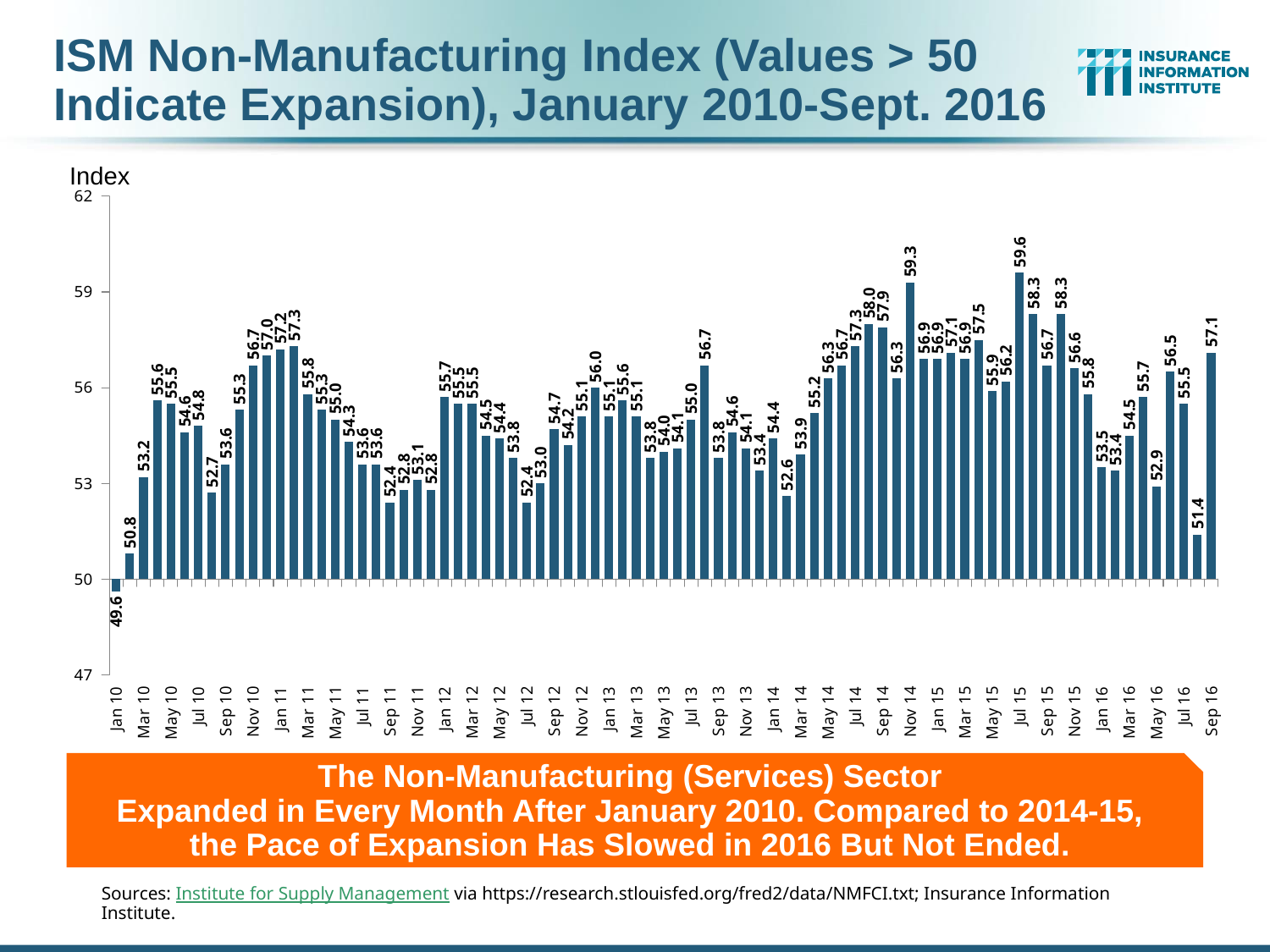
Which is larger, the value for Jul 15 or the value for Nov 14? Jul 15 What is the ISM Non-Manufacturing Index value for Sep 16, the last bar on the chart? 57.1 What is the difference between the Sep 16 value (57.1) and the Jan 10 value (49.6)? 7.5 What is the highest value shown on the chart? 59.6 Is the value for Jan 10 greater or less than 50? less What type of chart is shown on the slide? bar chart Which month has the highest ISM Non-Manufacturing Index value on the chart? Jul 15 What is the ISM Non-Manufacturing Index value for Nov 14? 59.3 Which month has the lowest ISM Non-Manufacturing Index value on the chart? Jan 10 What is the label on the vertical axis of the chart? Index What is the ISM Non-Manufacturing Index value for Jan 10? 49.6